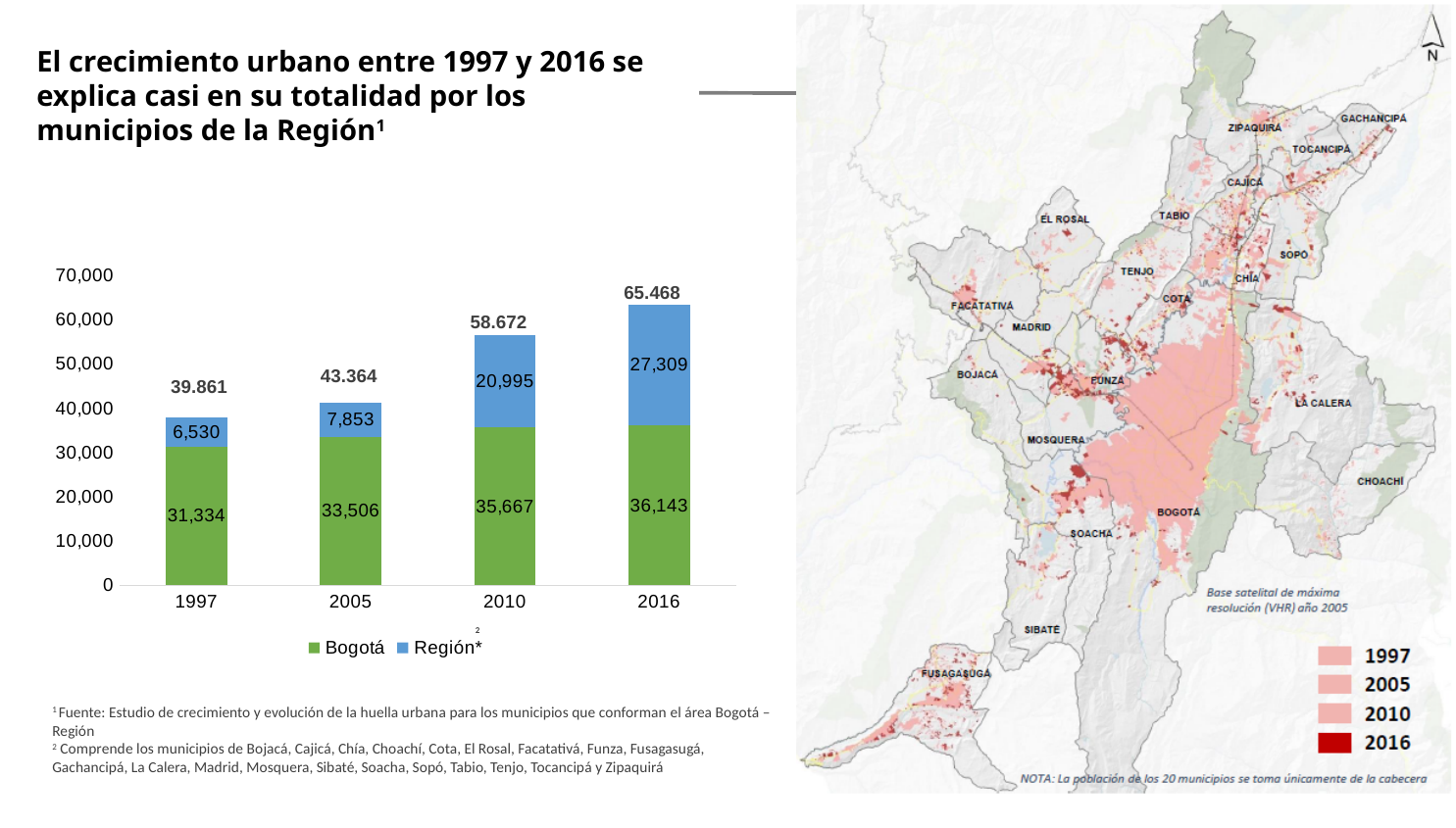
In the bar chart, what is the value for Región* in 2016? 27,309 In the bar chart, what is the difference between the Bogotá values for 2016 and 1997? 4,809 In the bar chart, which year has the highest value for Región*? 2016 In the bar chart, do the stacked bar totals rise or fall from 1997 to 2016? Rise In the bar chart, what is the difference between the Región* values for 2016 and 2010? 6,314 In the bar chart, which is larger in 2005: the Bogotá value or the Región* value? Bogotá How many series does the legend of the bar chart list? 2 In the bar chart, what is the total of the stacked bar for 2010? 58.672 What kind of chart is shown on the left of the slide? Stacked bar chart In the bar chart, which year has the lowest value for Bogotá? 1997 In the bar chart, what is the value for Bogotá in 1997? 31,334 How many years are shown on the x axis of the bar chart? 4